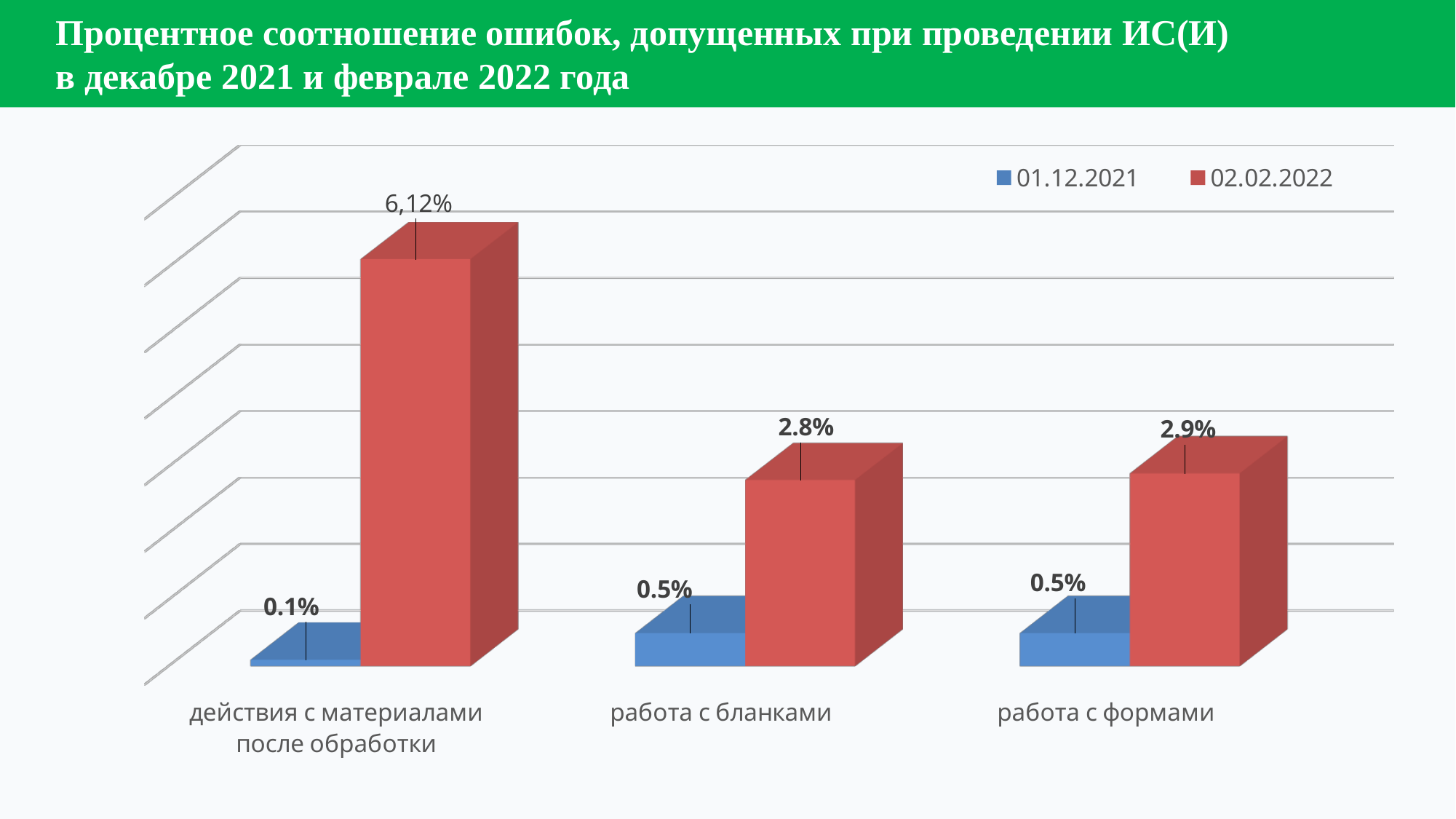
Which category has the lowest value for the 01.12.2021 series? действия с материалами после обработки How many series does the legend list? 2 What value is shown for 02.02.2022 in the category "работа с формами"? 2.9% What value is shown for 01.12.2021 in the category "действия с материалами после обработки"? 0.1% How many categories are shown on the x axis? 3 What is the difference between the 02.02.2022 and 01.12.2021 values for "работа с формами"? 2.4% What kind of chart is shown on the slide? bar chart Which category has the highest value for the 02.02.2022 series? действия с материалами после обработки What value is shown for 01.12.2021 in the category "работа с бланками"? 0.5% What value is shown for 02.02.2022 in the category "действия с материалами после обработки"? 6,12% Which is larger: the 02.02.2022 value for "работа с формами" or for "работа с бланками"? работа с формами What is the difference between the 02.02.2022 and 01.12.2021 values for "работа с бланками"? 2.3%